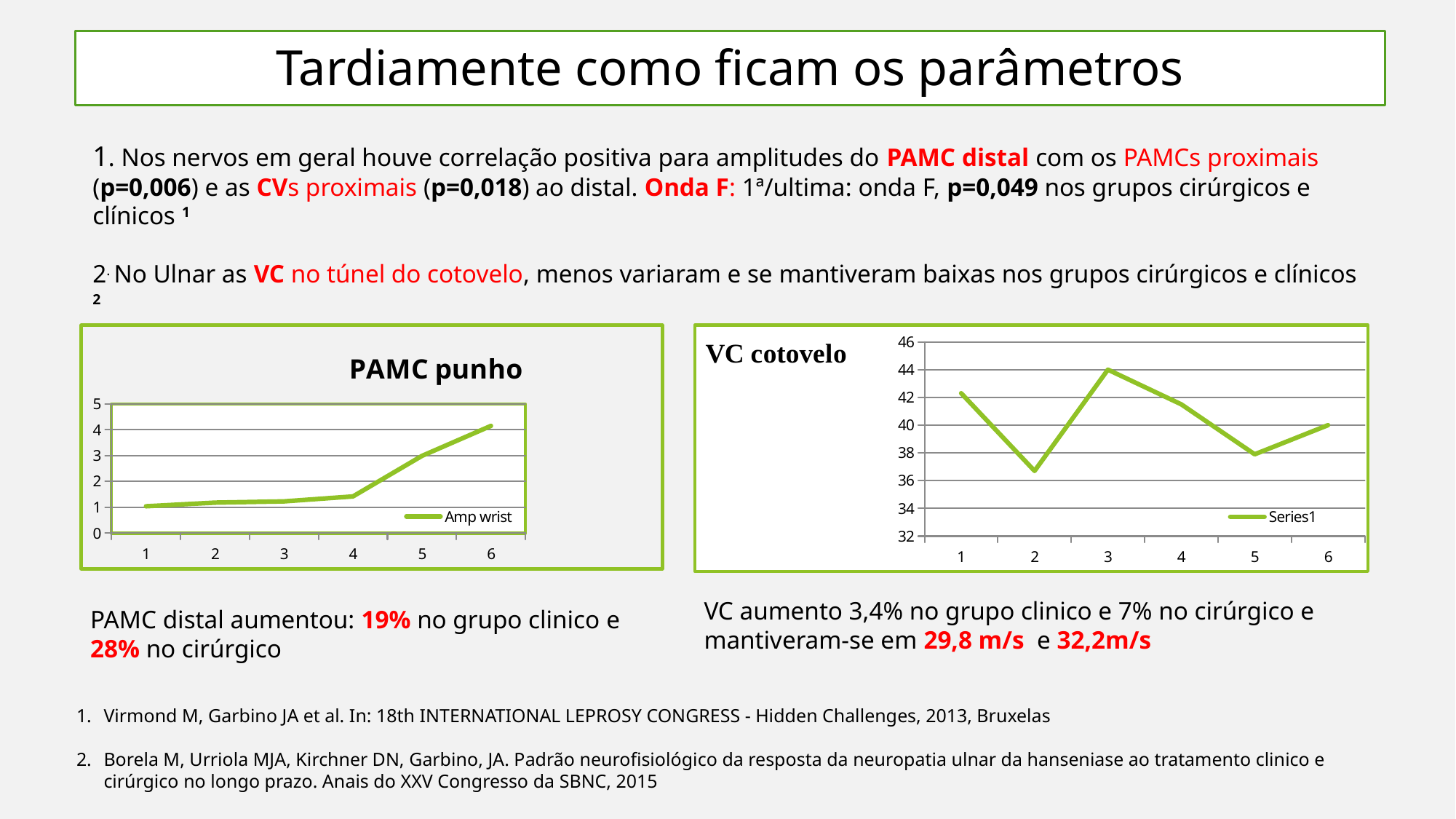
How many points are plotted on the "PAMC punho" chart? 6 What kind of chart is the "VC cotovelo" chart? line chart On the "VC cotovelo" chart, which point has the lowest value? 2 What is the legend entry on the "VC cotovelo" chart? Series1 On the "PAMC punho" chart, do the values rise or fall from point 1 to point 6? rise On the "PAMC punho" chart, is the value at point 6 greater or less than 4? greater On the "PAMC punho" chart, which point has the highest value? 6 How many series does the legend of the "VC cotovelo" chart list? 1 What is the legend entry on the "PAMC punho" chart? Amp wrist What kind of chart is the "PAMC punho" chart? line chart On the "VC cotovelo" chart, which point has the highest value? 3 On the "VC cotovelo" chart, is the value at point 2 greater or less than 38? less